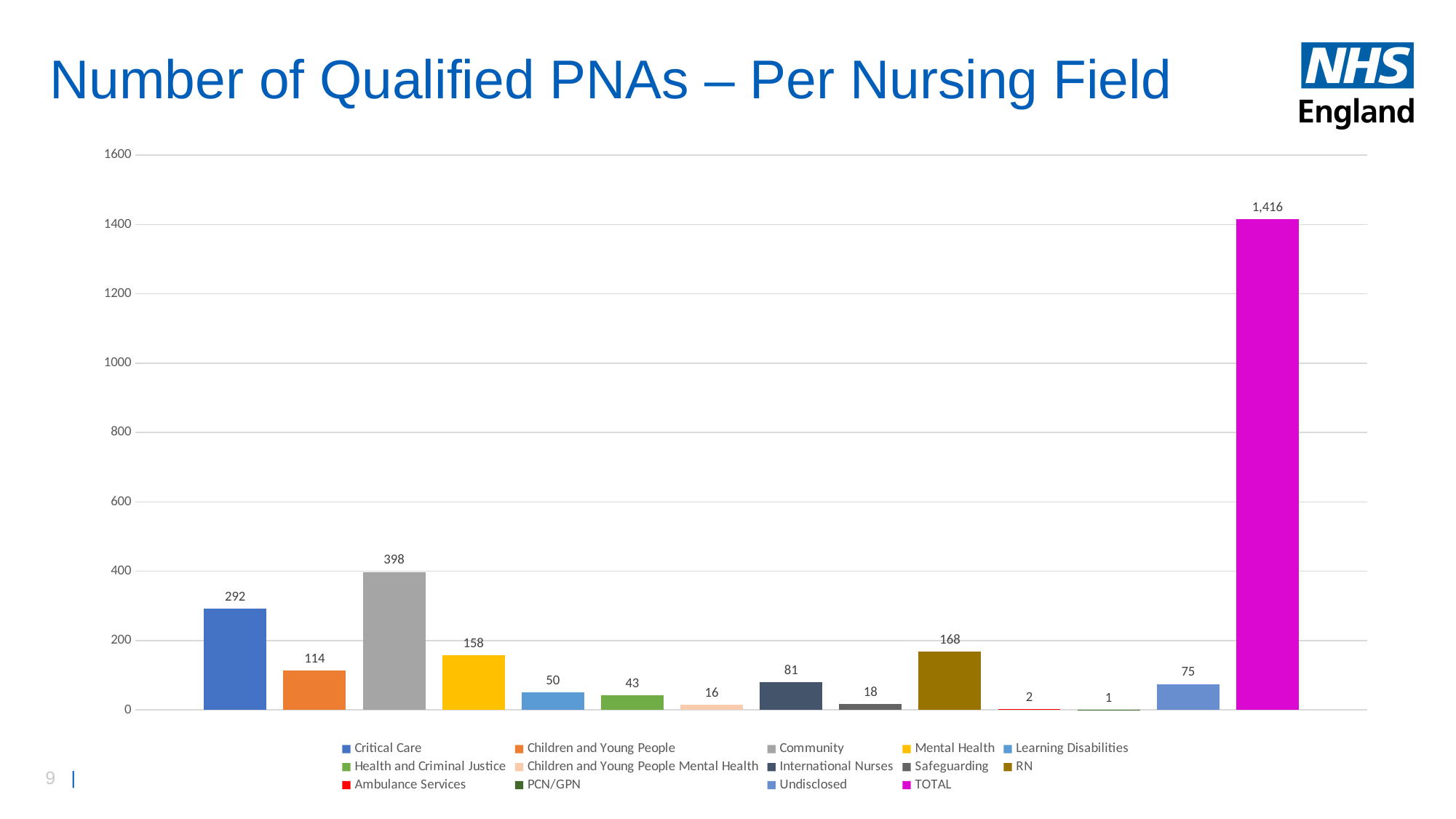
How many bars are plotted on the chart? 14 What is the value for Community? 398 Excluding the TOTAL bar, which nursing field has the highest number of qualified PNAs? Community Which is larger, the value for Mental Health or the value for RN? RN What is the value for Critical Care? 292 What is the value for RN? 168 What is the difference between the values for Community and Critical Care? 106 What is the value for Safeguarding? 18 What is the value shown for TOTAL? 1,416 What type of chart is shown on the slide? Bar chart How many entries does the legend list? 14 Which nursing field has the lowest number of qualified PNAs? PCN/GPN